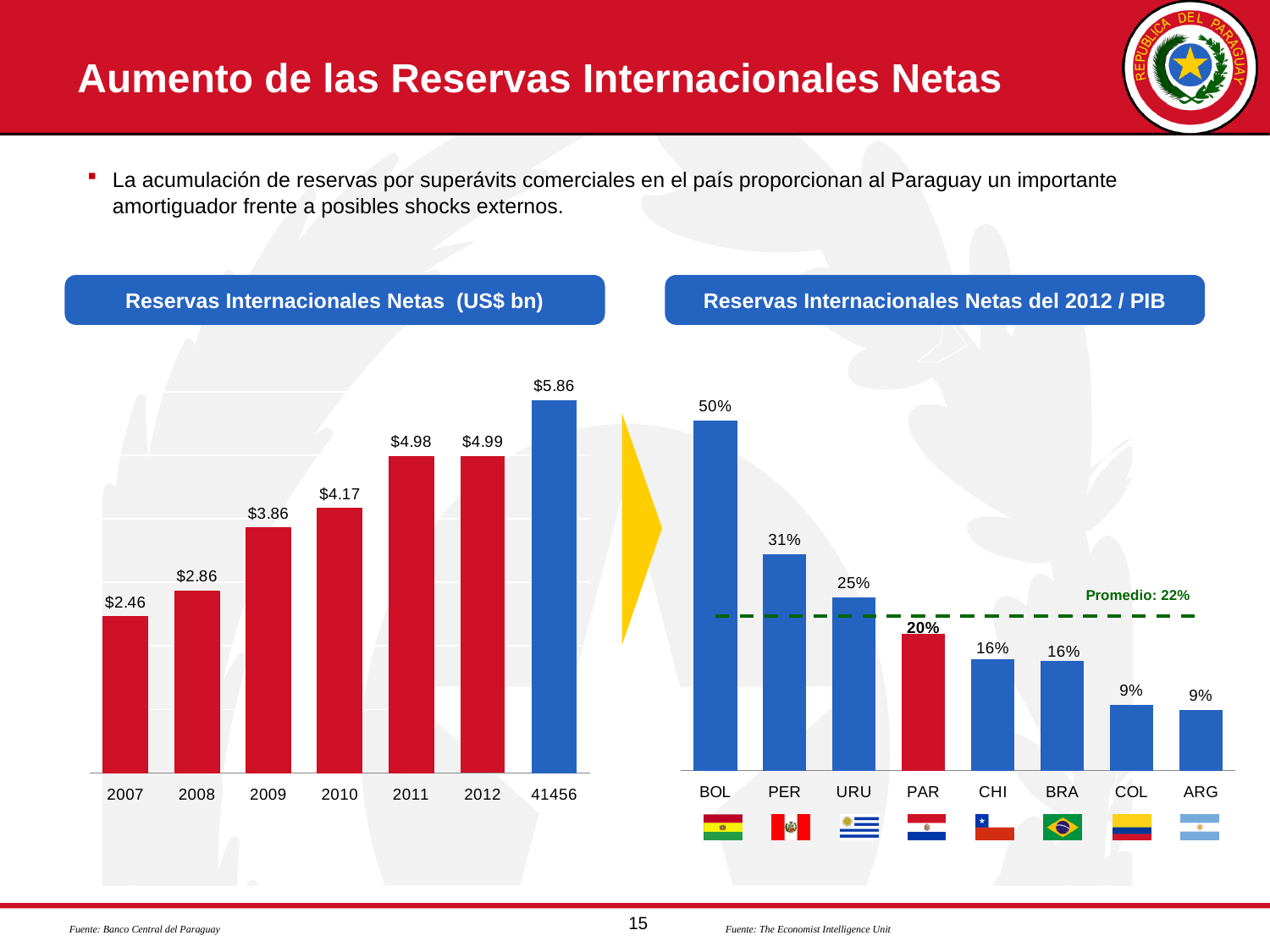
In the chart titled "Reservas Internacionales Netas del 2012 / PIB", what is the difference between the values for BOL and ARG? 41% In the chart titled "Reservas Internacionales Netas (US$ bn)", what is the value for 2009? $3.86 In the chart titled "Reservas Internacionales Netas del 2012 / PIB", what is the value for PER? 31% In the chart titled "Reservas Internacionales Netas del 2012 / PIB", which country has the highest value? BOL In the chart titled "Reservas Internacionales Netas del 2012 / PIB", what is the value for PAR? 20% In the chart titled "Reservas Internacionales Netas (US$ bn)", do the values generally rise or fall from 2007 to 2012? rise In the chart titled "Reservas Internacionales Netas (US$ bn)", which category has the lowest value? 2007 In the chart titled "Reservas Internacionales Netas del 2012 / PIB", which is larger, the value for URU or the value for CHI? URU In the chart titled "Reservas Internacionales Netas (US$ bn)", what is the value for 2012? $4.99 In the chart titled "Reservas Internacionales Netas (US$ bn)", how many bars are plotted? 7 In the chart titled "Reservas Internacionales Netas (US$ bn)", what is the difference between the values for 2011 and 2007? $2.52 In the chart titled "Reservas Internacionales Netas del 2012 / PIB", what average value is marked by the dashed line? Promedio: 22%